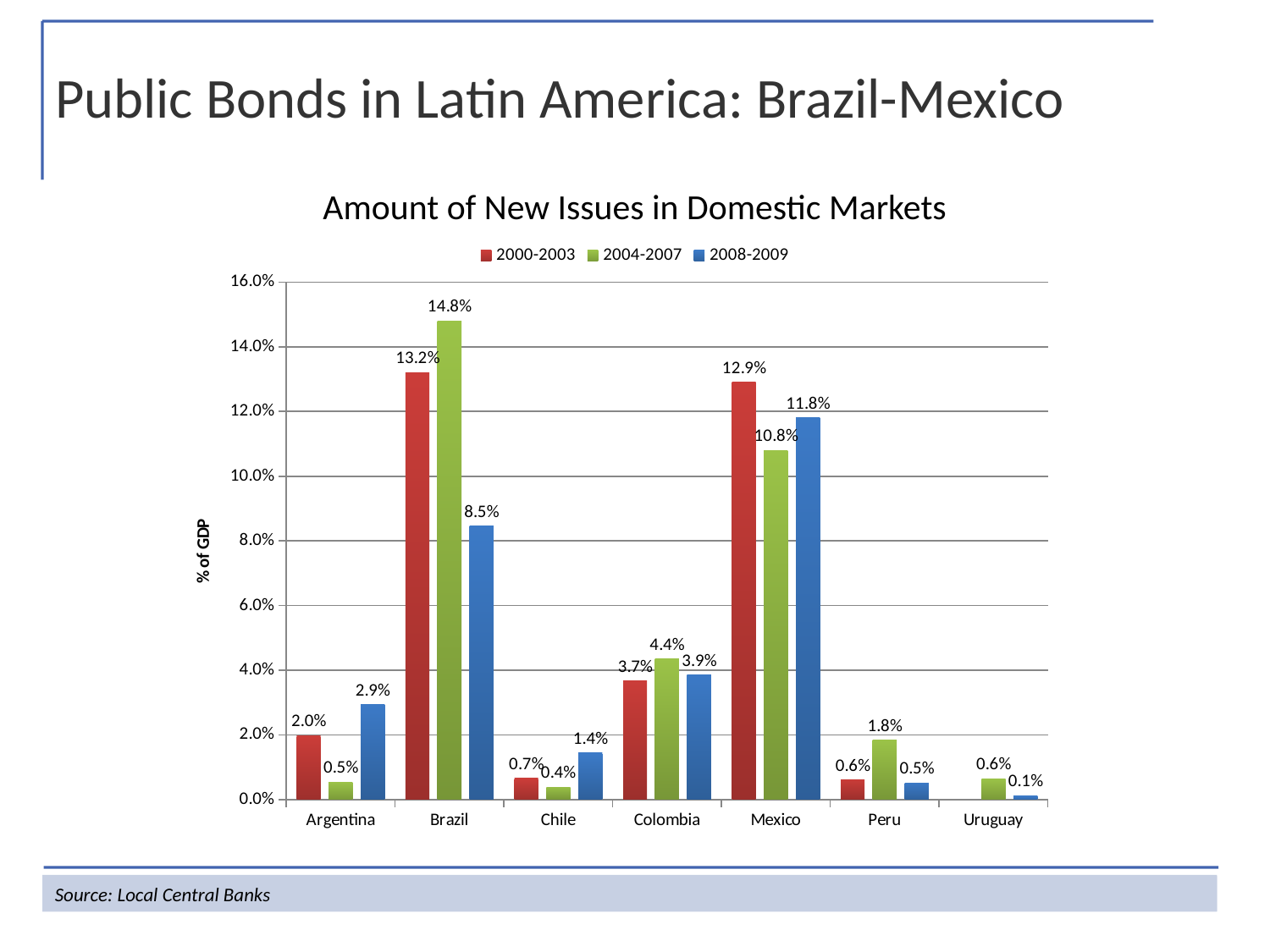
What is the value for Peru in the 2004-2007 series? 1.8% How many series does the legend list? 3 What is the label on the vertical axis? % of GDP How many countries are shown on the x axis? 7 In the 2000-2003 series, which is larger: Brazil or Mexico? Brazil Is the value for Colombia in the 2004-2007 series greater or less than 4.0%? greater Which country has the highest value in the 2004-2007 series? Brazil Which country has the lowest value in the 2008-2009 series? Uruguay What kind of chart is shown on the slide? bar chart What is the value for Mexico in the 2008-2009 series? 11.8% What is the difference between Brazil's 2000-2003 value and its 2008-2009 value? 4.7 percentage points What is the value for Brazil in the 2004-2007 series? 14.8%